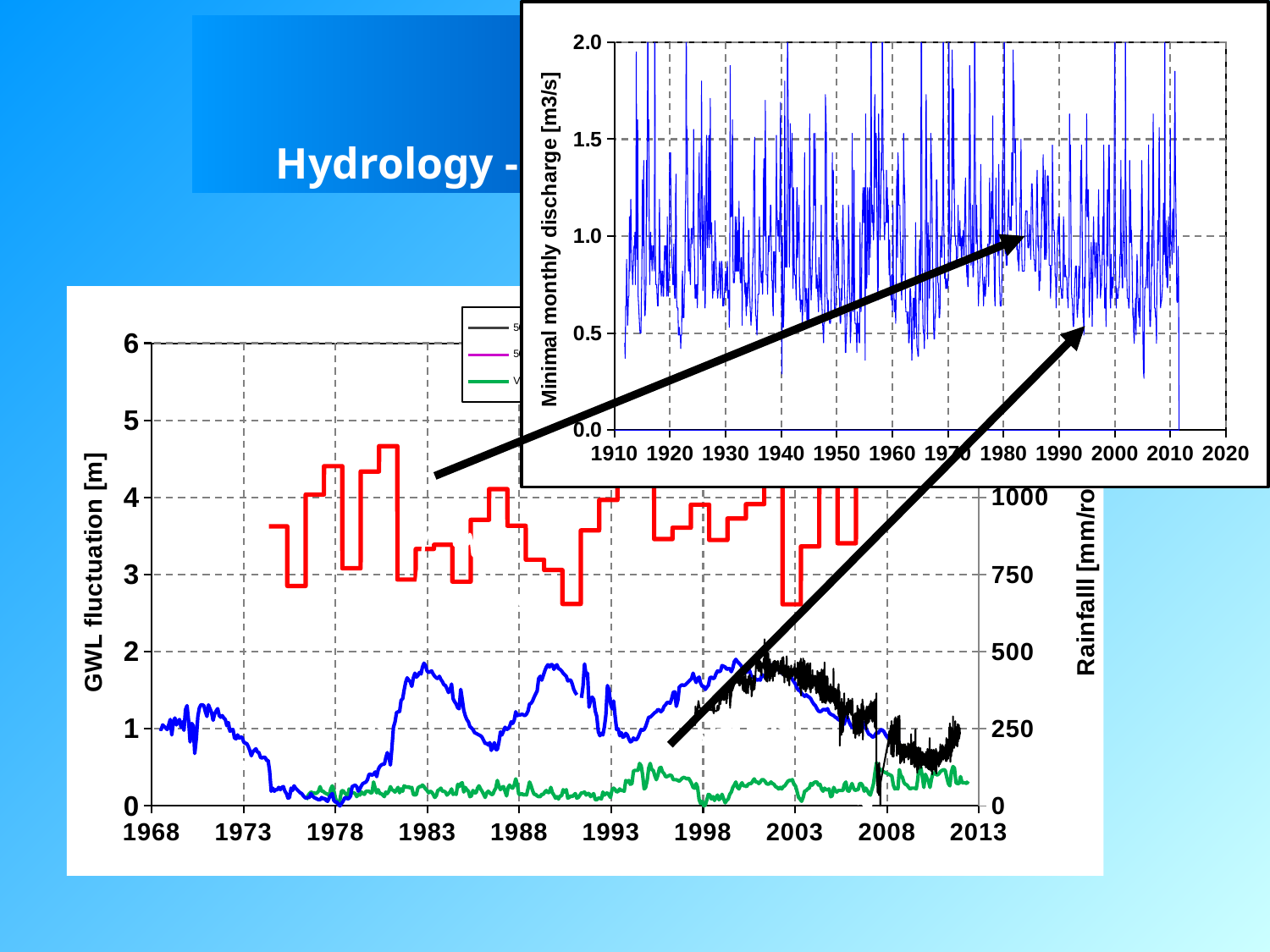
What kind of chart is the top-right chart showing minimal monthly discharge? line chart In the bottom-left chart, is the value of the blue line around 1978 greater or less than 1 on the left axis? less What kind of chart is the bottom-left chart with GWL fluctuation on the left axis? line chart In the bottom-left chart, is the value of the blue line around 1983 greater or less than 1 on the left axis? greater In the bottom-left chart, is the value of the black line around 2003 greater or less than 1 on the left axis? greater In the top-right chart, what is the label of the y axis? Minimal monthly discharge [m3/s] In the bottom-left chart, is the blue line higher around 1983 or around 1978? around 1983 In the bottom-left chart, what is the label of the left y axis? GWL fluctuation [m]